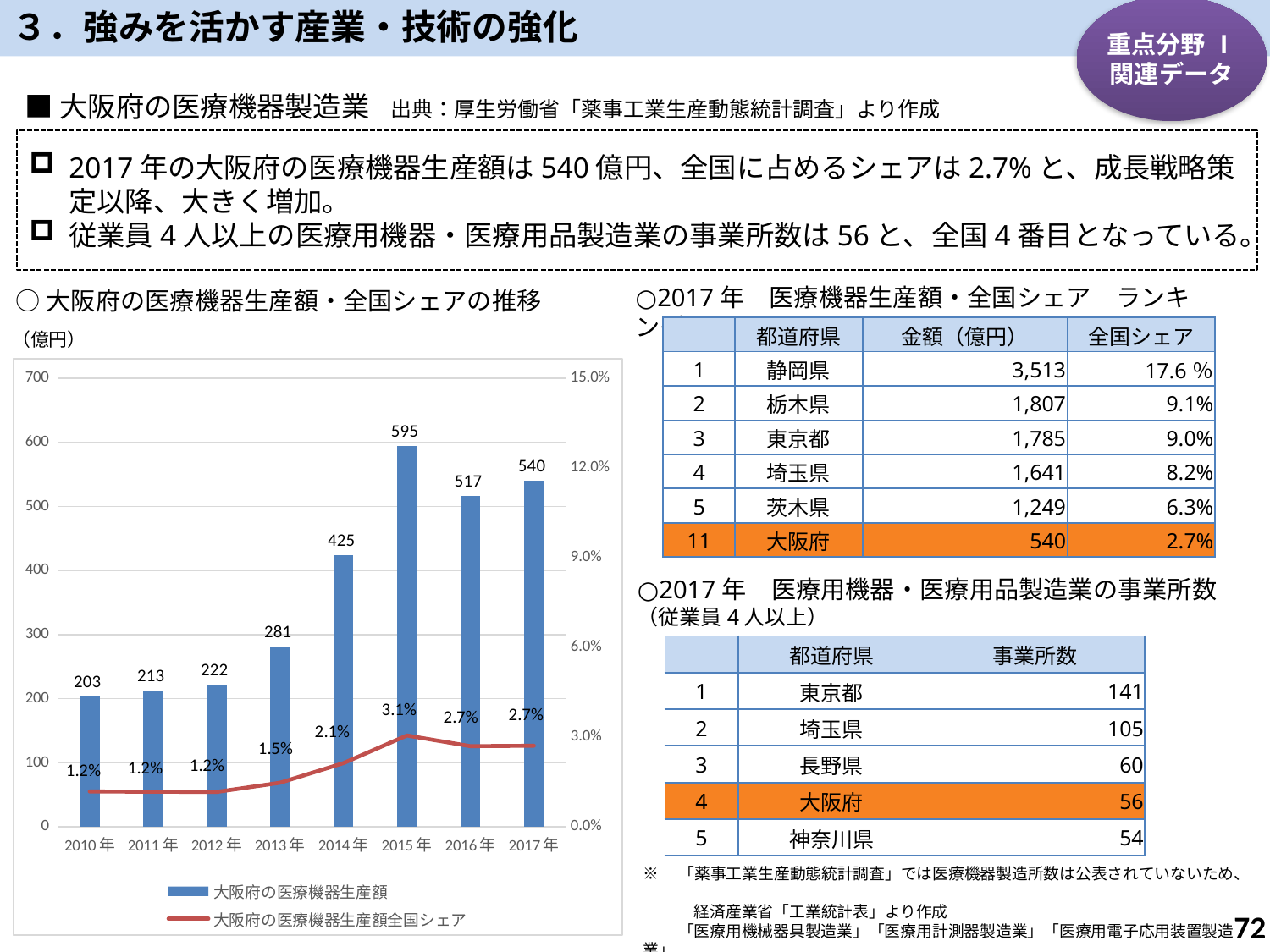
What kind of chart is used to show 大阪府の医療機器生産額? Bar chart What is the 大阪府の医療機器生産額全国シェア for 2013年? 1.5% How many years are shown on the x axis of the chart? 8 What is the value of 大阪府の医療機器生産額 for 2010年? 203 Does the 大阪府の医療機器生産額 rise or fall from 2010年 to 2015年? Rise Which year has the highest 大阪府の医療機器生産額? 2015年 How many series does the chart legend list? 2 Which is larger, the 大阪府の医療機器生産額 for 2014年 or for 2016年? 2016年 What is the difference in 大阪府の医療機器生産額 between 2017年 and 2016年? 23 What is the value of 大阪府の医療機器生産額 for 2015年? 595 Which year has the lowest 大阪府の医療機器生産額? 2010年 What is the 大阪府の医療機器生産額全国シェア for 2015年? 3.1%